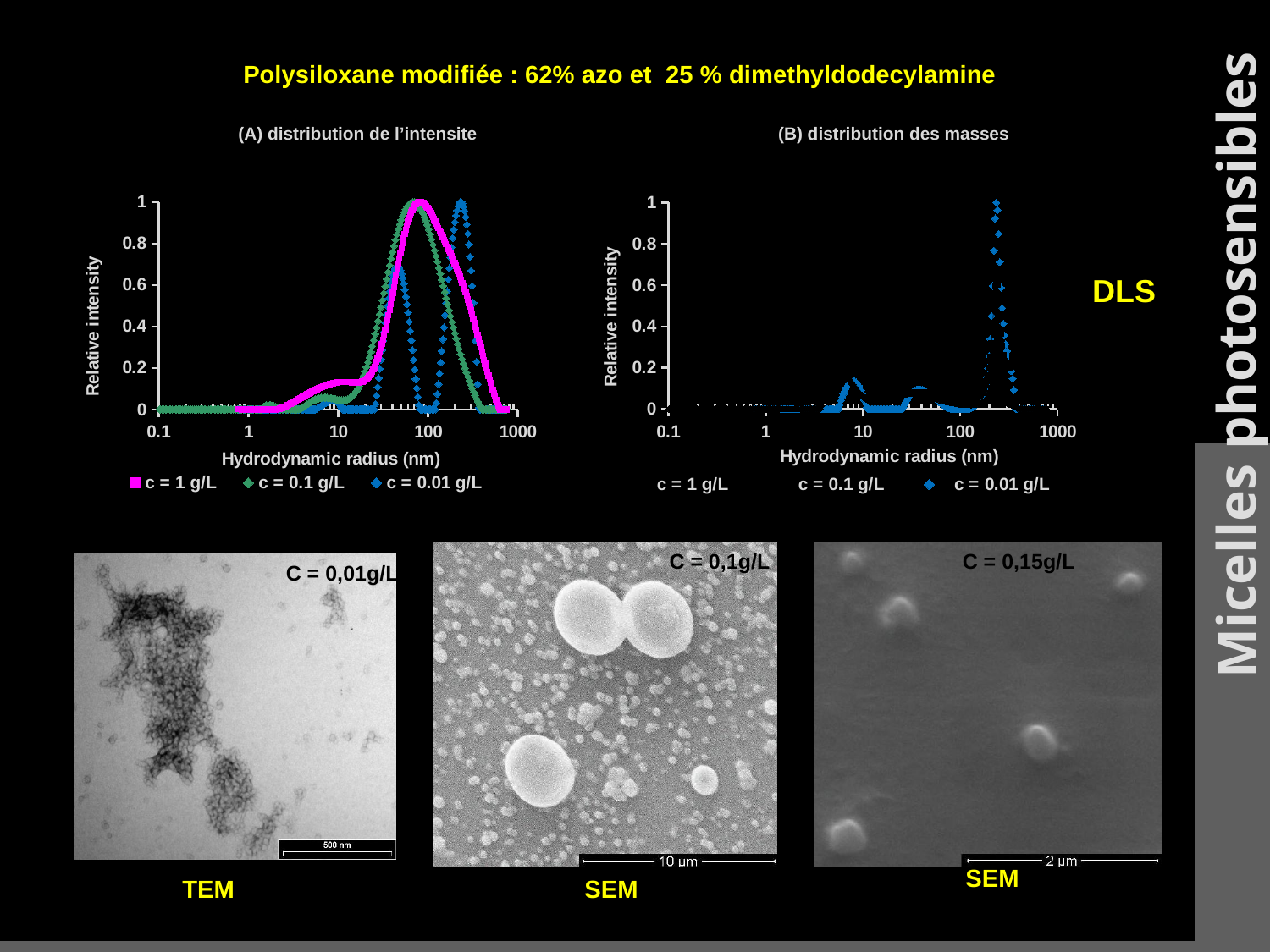
In chart (A) distribution de l'intensite, what colour is the c = 1 g/L series? magenta How many series does the legend of chart (B) distribution des masses list? 3 In chart (A) distribution de l'intensite, is the relative intensity of the c = 1 g/L series at 10 nm greater or less than 0.2? less In chart (A) distribution de l'intensite, is the hydrodynamic radius at which the c = 0.01 g/L series peaks greater or less than 100 nm? greater In chart (B) distribution des masses, does the c = 0.01 g/L series rise or fall between 100 nm and its peak near 250 nm? rise In chart (B) distribution des masses, what is the peak relative intensity reached by the c = 0.01 g/L series? 1 In chart (A) distribution de l'intensite, what is the peak relative intensity reached by the c = 0.01 g/L series? 1 In chart (A) distribution de l'intensite, at a hydrodynamic radius of 10 nm, which series has the higher relative intensity, c = 1 g/L or c = 0.01 g/L? c = 1 g/L What is the x-axis label of chart (A) distribution de l'intensite? Hydrodynamic radius (nm) In chart (B) distribution des masses, is the hydrodynamic radius at which the c = 0.01 g/L series peaks greater or less than 100 nm? greater How many series does the legend of chart (A) distribution de l'intensite list? 3 What kind of chart is chart (A) distribution de l'intensite? line chart